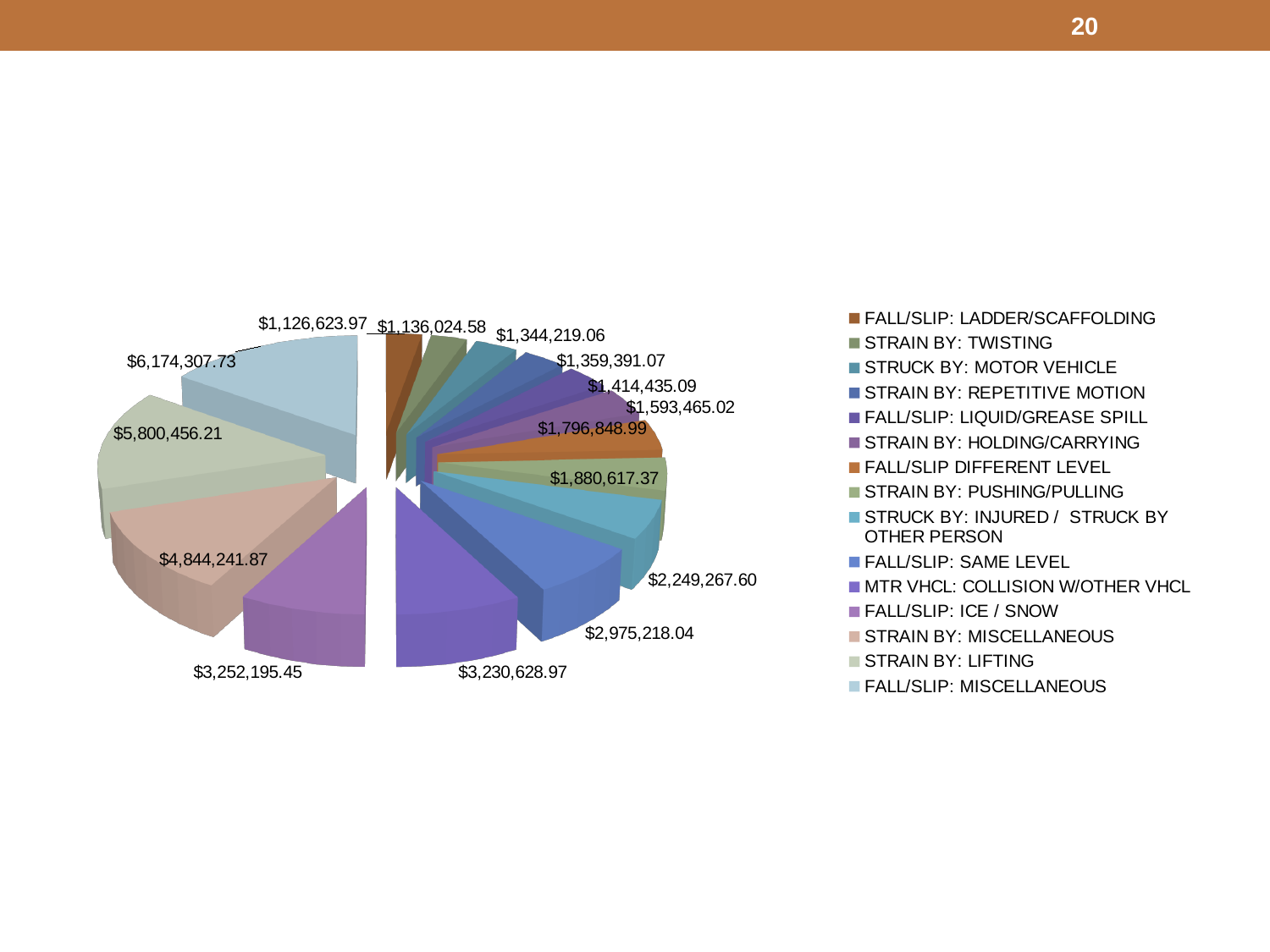
What is the difference between the FALL/SLIP: MISCELLANEOUS value and the STRAIN BY: LIFTING value? $373,851.52 Which is larger, the slice for STRAIN BY: LIFTING or the slice for STRAIN BY: MISCELLANEOUS? STRAIN BY: LIFTING Which category has the largest slice in the pie chart? FALL/SLIP: MISCELLANEOUS What kind of chart is shown on the slide? pie chart What is the value of the smallest slice in the pie chart? $1,126,623.97 What is the value for STRAIN BY: MISCELLANEOUS? $4,844,241.87 What is the value for STRAIN BY: LIFTING? $5,800,456.21 How many slices does the pie chart have? 15 How many entries does the legend list? 15 What is the value for FALL/SLIP: MISCELLANEOUS? $6,174,307.73 What is the first entry listed in the legend? FALL/SLIP: LADDER/SCAFFOLDING What is the value of the largest slice in the pie chart? $6,174,307.73